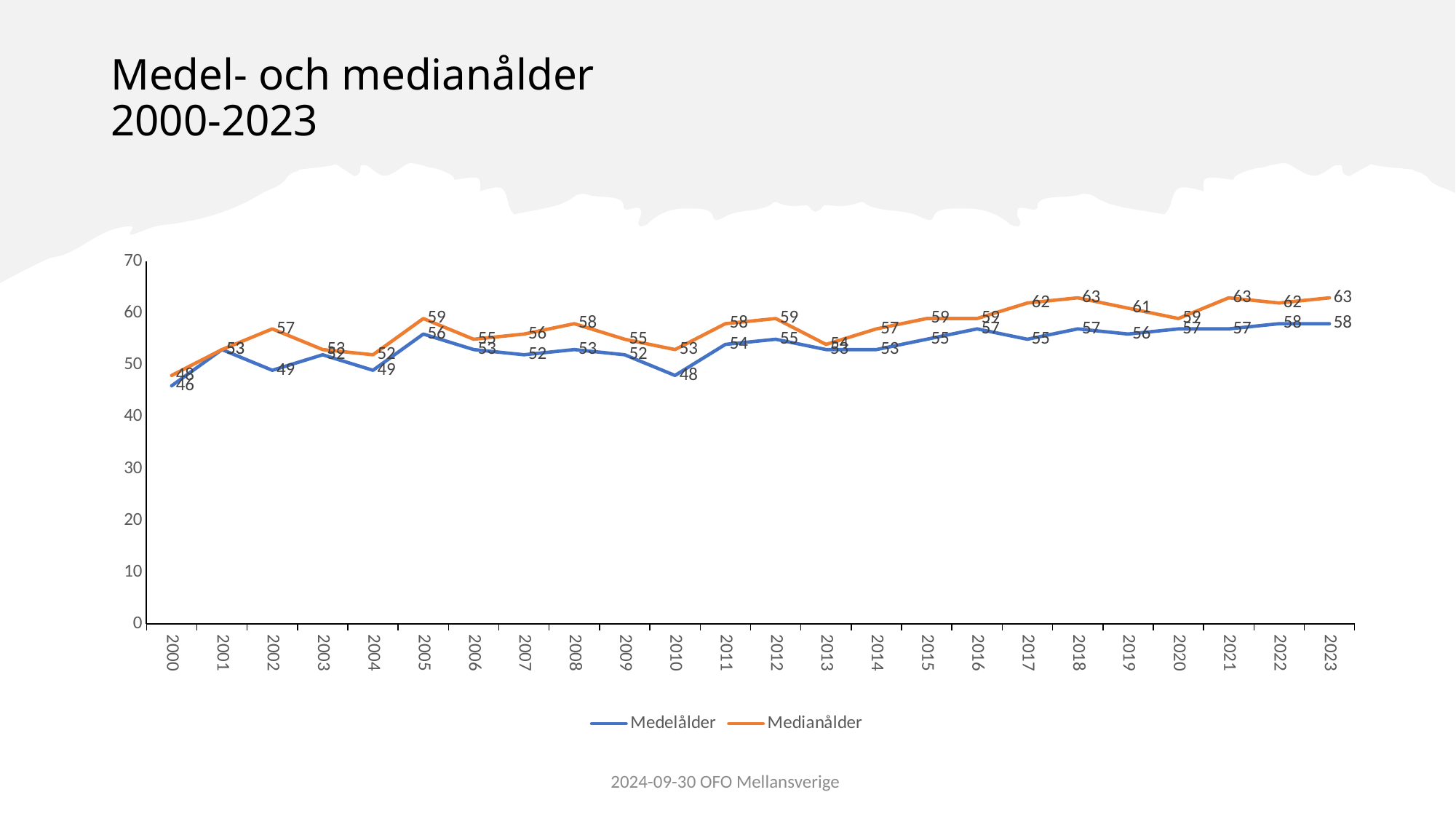
Is the Medianålder value for 2021 greater or less than 60? greater What is the Medelålder value for 2005? 56 What is the Medianålder value for 2017? 62 What is the difference between Medianålder and Medelålder in 2018? 6 Which is larger in 2002, Medelålder or Medianålder? Medianålder What kind of chart is shown on the slide? line chart What is the Medianålder value for 2023? 63 What is the Medelålder value for 2010? 48 How many years are shown on the x axis? 24 Overall, does the Medianålder line rise or fall from 2000 to 2023? rise In which year is the Medelålder value lowest? 2000 How many series does the legend list? 2